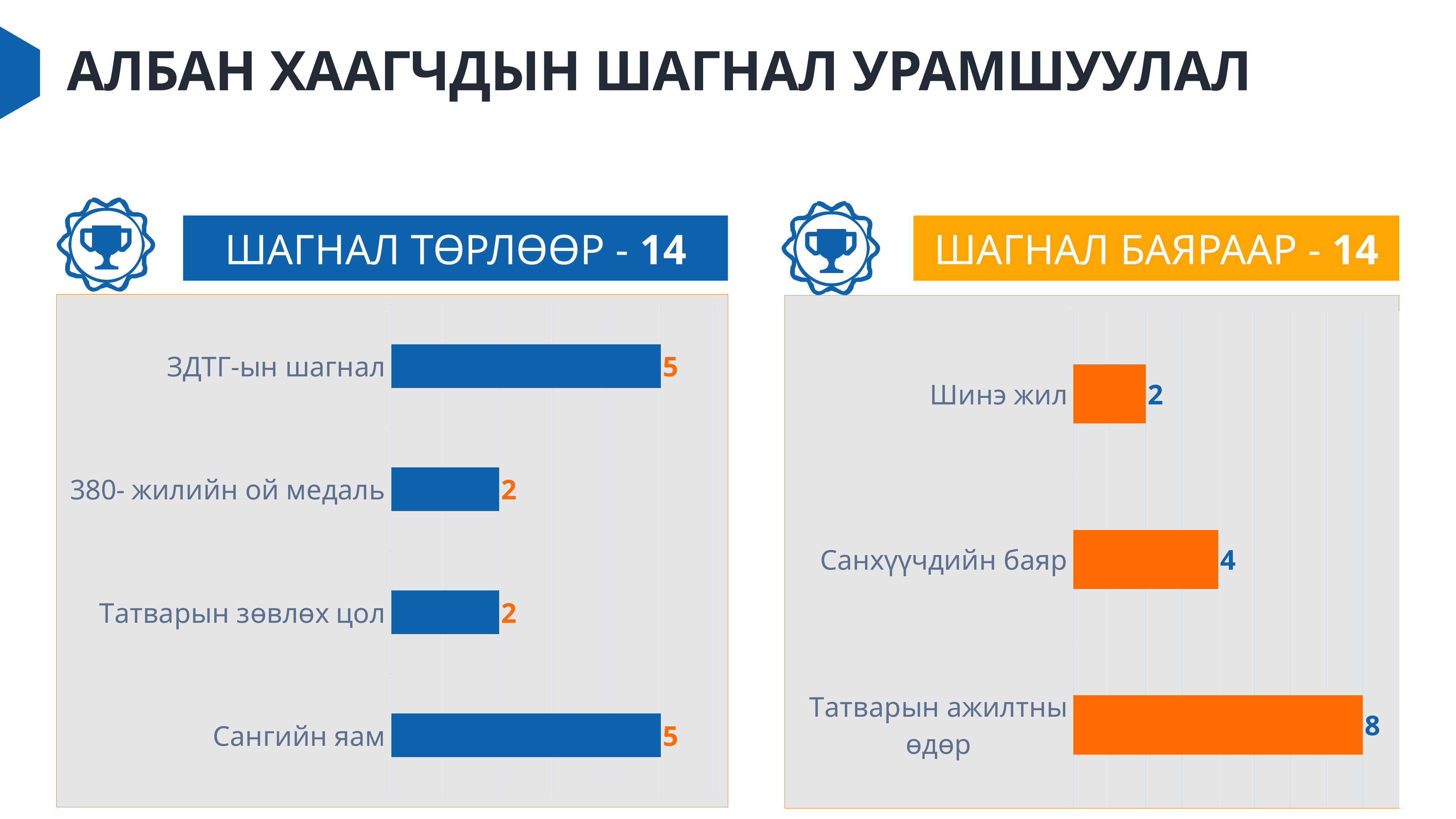
In the left chart (ШАГНАЛ ТӨРЛӨӨР - 14), what is the value for Сангийн яам? 5 In the right chart (ШАГНАЛ БАЯРААР - 14), what is the value for Санхүүчдийн баяр? 4 In the left chart (ШАГНАЛ ТӨРЛӨӨР - 14), what is the value for 380- жилийн ой медаль? 2 In the right chart (ШАГНАЛ БАЯРААР - 14), which category has the lowest value? Шинэ жил In the right chart (ШАГНАЛ БАЯРААР - 14), what is the value for Шинэ жил? 2 How many categories does the left chart (ШАГНАЛ ТӨРЛӨӨР - 14) show? 4 In the right chart (ШАГНАЛ БАЯРААР - 14), what is the difference between the values for Татварын ажилтны өдөр and Санхүүчдийн баяр? 4 In the right chart (ШАГНАЛ БАЯРААР - 14), which is larger: Санхүүчдийн баяр or Шинэ жил? Санхүүчдийн баяр In the left chart (ШАГНАЛ ТӨРЛӨӨР - 14), what is the difference between the values for ЗДТГ-ын шагнал and Татварын зөвлөх цол? 3 In the right chart (ШАГНАЛ БАЯРААР - 14), which category has the highest value? Татварын ажилтны өдөр What kind of chart is the right chart (ШАГНАЛ БАЯРААР - 14)? Bar chart In the left chart (ШАГНАЛ ТӨРЛӨӨР - 14), what is the value for ЗДТГ-ын шагнал? 5